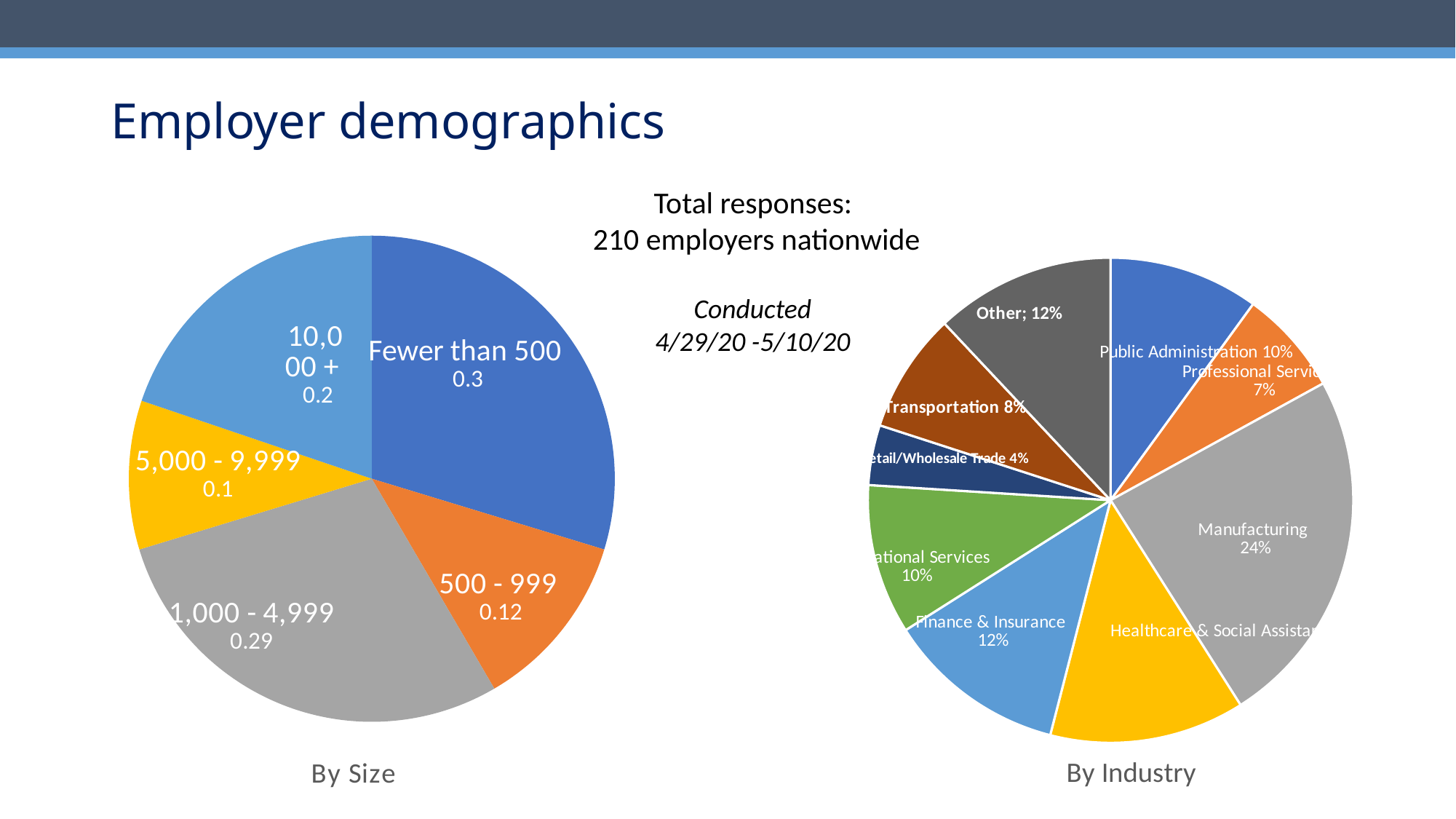
How many slices does the By Size pie chart have? 5 In the By Industry chart, which is larger, Transportation or Professional Services? Transportation In the By Industry chart, what percentage is shown for Manufacturing? 24% In the By Size chart, what share is labelled for the 'Fewer than 500' slice? 0.3 In the By Size chart, what value is shown for the '500 - 999' slice? 0.12 In the By Industry chart, which industry has the largest slice? Manufacturing In the By Size chart, which size category has the largest slice? Fewer than 500 In the By Size chart, what is the difference between the values for '1,000 - 4,999' and '10,000 +'? 0.09 In the By Industry chart, what percentage is shown for Retail/Wholesale Trade? 4% In the By Size chart, which size category has the smallest slice? 5,000 - 9,999 In the By Industry chart, what is the difference between the percentages for Finance & Insurance and Public Administration? 2% What type of chart is used for the By Industry data? Pie chart